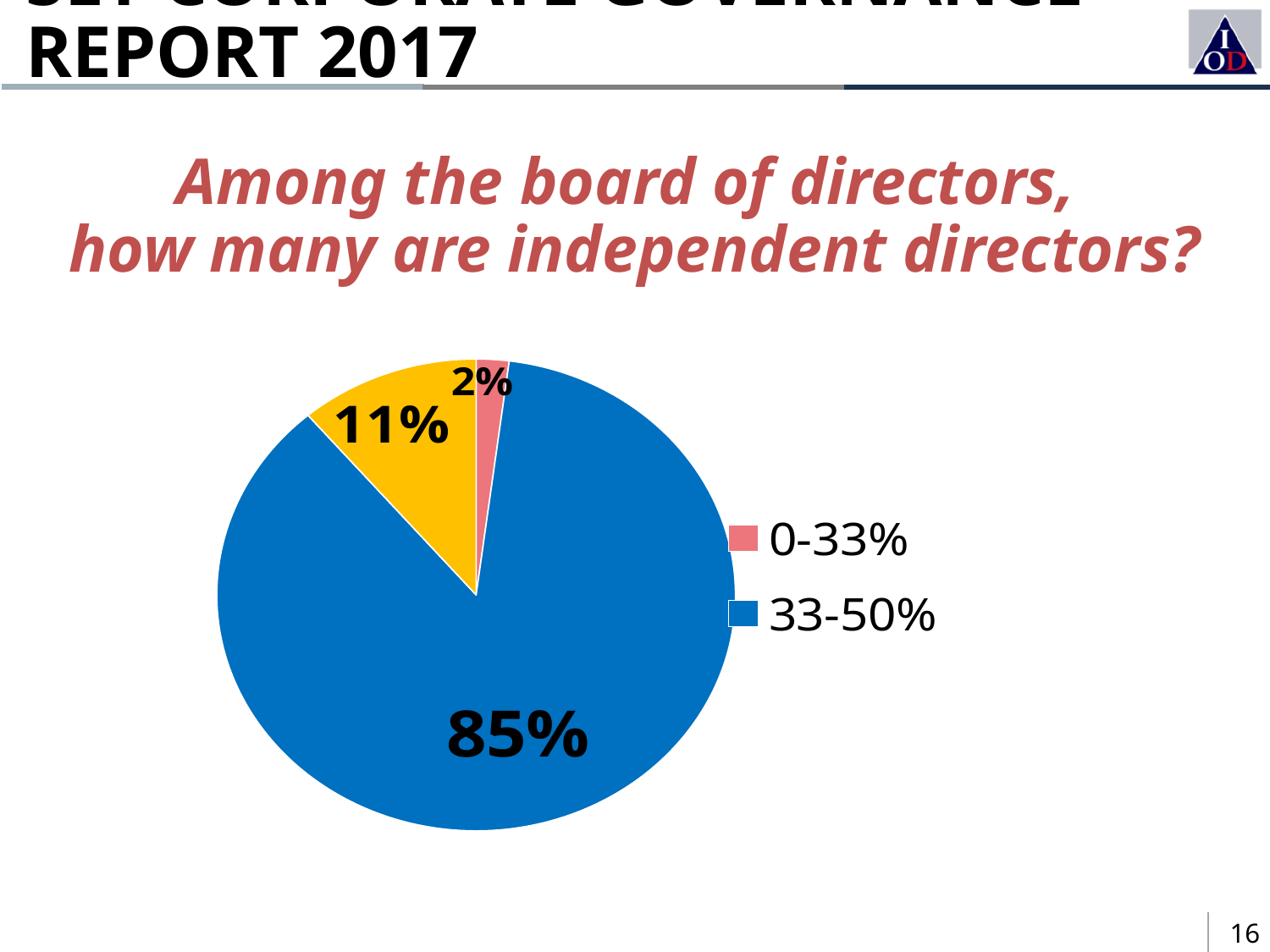
Which category has the smallest slice of the pie? 0-33% What is the difference between the 33-50% slice and the 0-33% slice? 83% What colour is the slice for the 33-50% category? Blue Which is larger, the 33-50% slice or the 0-33% slice? 33-50% How many entries does the legend list? 2 What kind of chart is shown on the slide? Pie chart Which category has the largest slice of the pie? 33-50% What share of the pie is labelled for the 33-50% category? 85% How many slices does the pie chart have? 3 What share of the pie is labelled for the 0-33% category? 2% What percentage is shown on the yellow slice of the pie? 11% What is the difference between the 85% slice and the 11% slice? 74%